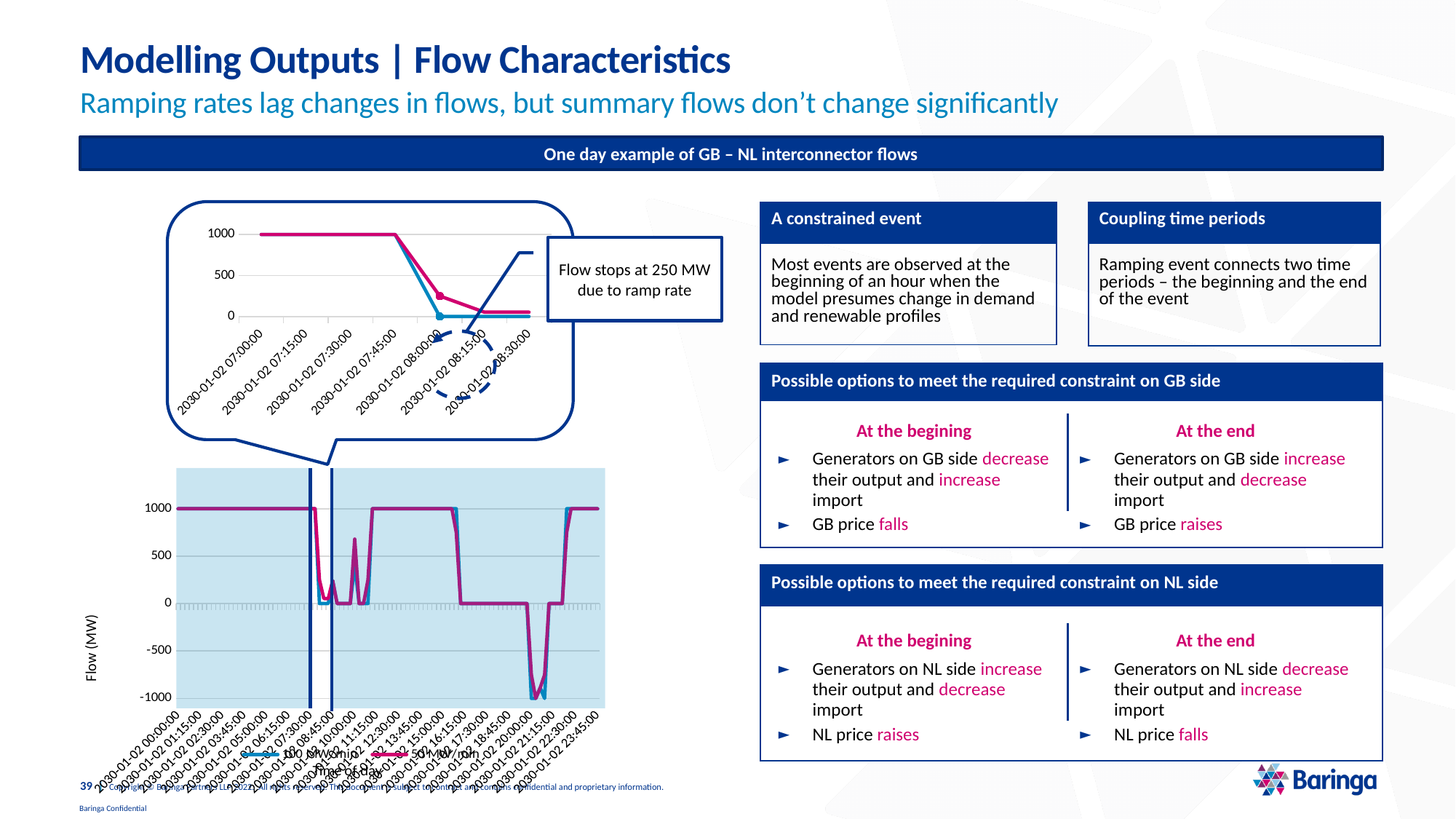
In the bottom-left chart, is the flow value at around 2030-01-02 20:30:00 greater or less than -500? less How many series does the legend of the bottom-left chart list? 2 In the zoomed-in inset chart, which series has the higher value at 2030-01-02 08:00:00, 100 MW/min or 50 MW/min? 50 MW/min What kind of chart is the large chart at the bottom left of the slide? line chart What is the y-axis title of the bottom-left chart? Flow (MW) How many time labels are shown on the x-axis of the zoomed-in inset chart? 7 What are the two series named in the legend of the bottom-left chart? 100 MW/min and 50 MW/min In the bottom-left chart, what is the flow value at 2030-01-02 17:30:00? 0 In the bottom-left chart, what is the flow value at 2030-01-02 00:00:00? 1000 In the zoomed-in inset chart, what is the flow value of both series at 2030-01-02 07:00:00? 1000 What is the lowest value shown on the y-axis of the bottom-left chart? -1000 In the zoomed-in inset chart, do the flow values rise or fall between 07:45:00 and 08:15:00? fall